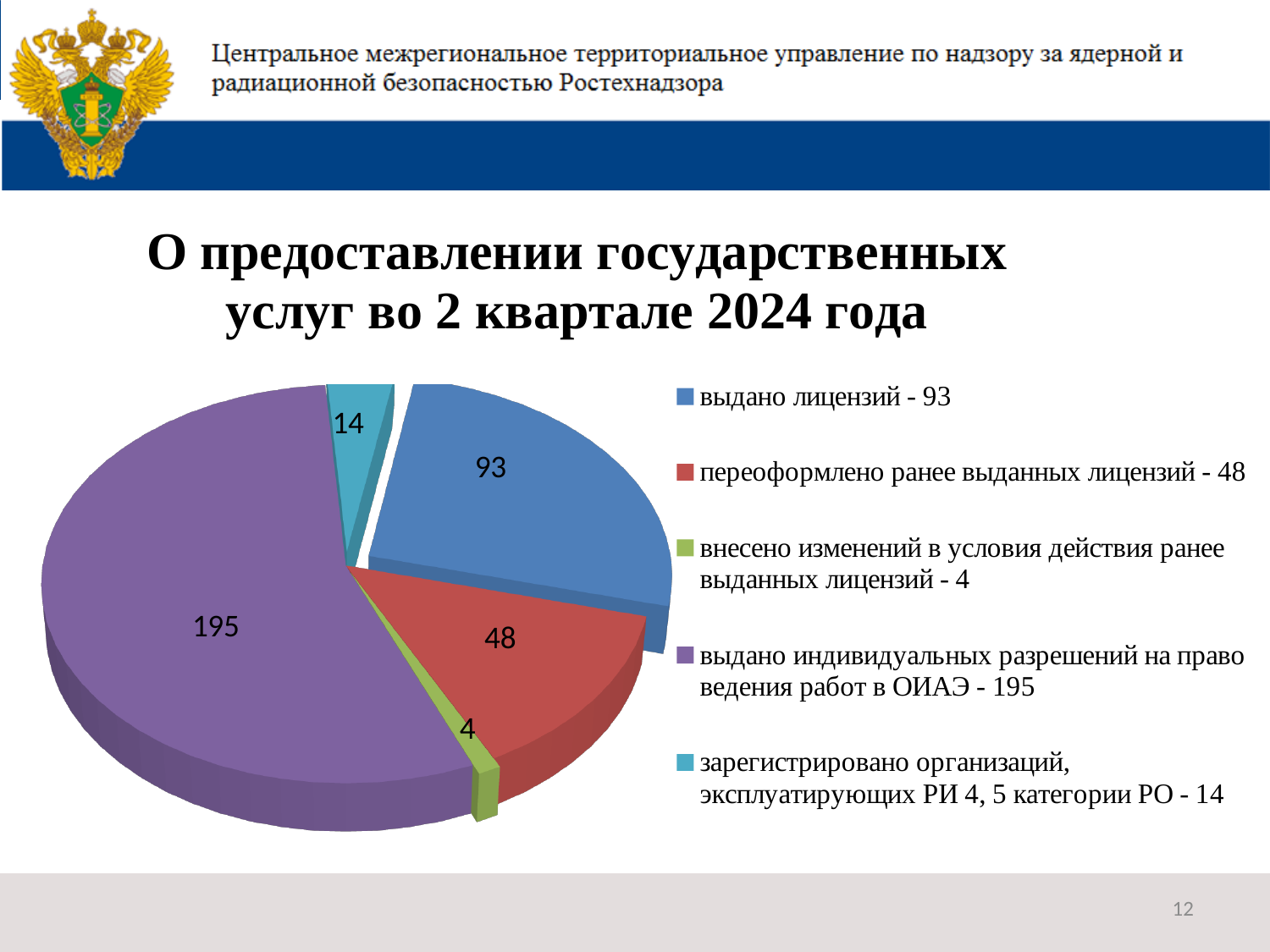
Which category has the smallest slice of the pie? внесено изменений в условия действия ранее выданных лицензий What is the difference between the value for "выдано лицензий" and the value for "переоформлено ранее выданных лицензий"? 45 How many slices does the pie chart have? 5 Which category has the largest slice of the pie? выдано индивидуальных разрешений на право ведения работ в ОИАЭ What is the value for "зарегистрировано организаций, эксплуатирующих РИ 4, 5 категории РО"? 14 What is the value for "переоформлено ранее выданных лицензий"? 48 Which is larger: the value for "зарегистрировано организаций, эксплуатирующих РИ 4, 5 категории РО" or the value for "внесено изменений в условия действия ранее выданных лицензий"? зарегистрировано организаций, эксплуатирующих РИ 4, 5 категории РО What is the value for "выдано лицензий"? 93 What colour is the slice for "выдано индивидуальных разрешений на право ведения работ в ОИАЭ"? purple What is the value for "выдано индивидуальных разрешений на право ведения работ в ОИАЭ"? 195 How many entries does the legend list? 5 What kind of chart is shown on the slide? pie chart